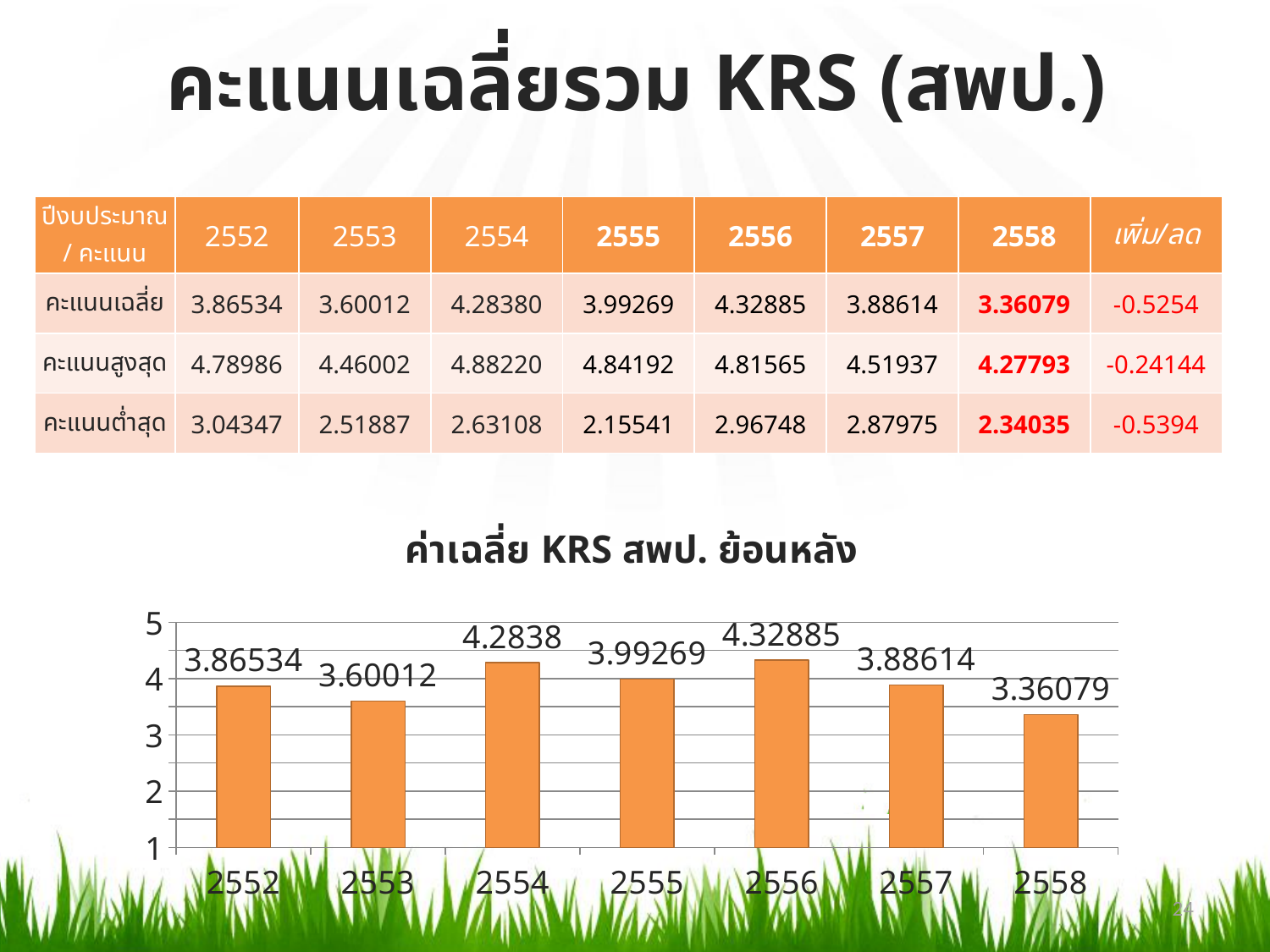
What is the title of the chart on the slide? ค่าเฉลี่ย KRS สพป. ย้อนหลัง How many years are plotted in the chart? 7 In the chart, what is the value for 2554? 4.2838 Which year has the highest value in the chart? 2556 In the chart, what is the value for 2558? 3.36079 What is the difference between the values for 2556 and 2558 in the chart? 0.96806 In the chart, what is the value for 2552? 3.86534 Which year has the lowest value in the chart? 2558 In the chart, which is larger, the value for 2555 or the value for 2557? 2555 What type of chart is shown on the slide? bar chart In the chart, do the values rise or fall from 2556 to 2558? fall What is the difference between the values for 2554 and 2553 in the chart? 0.68368